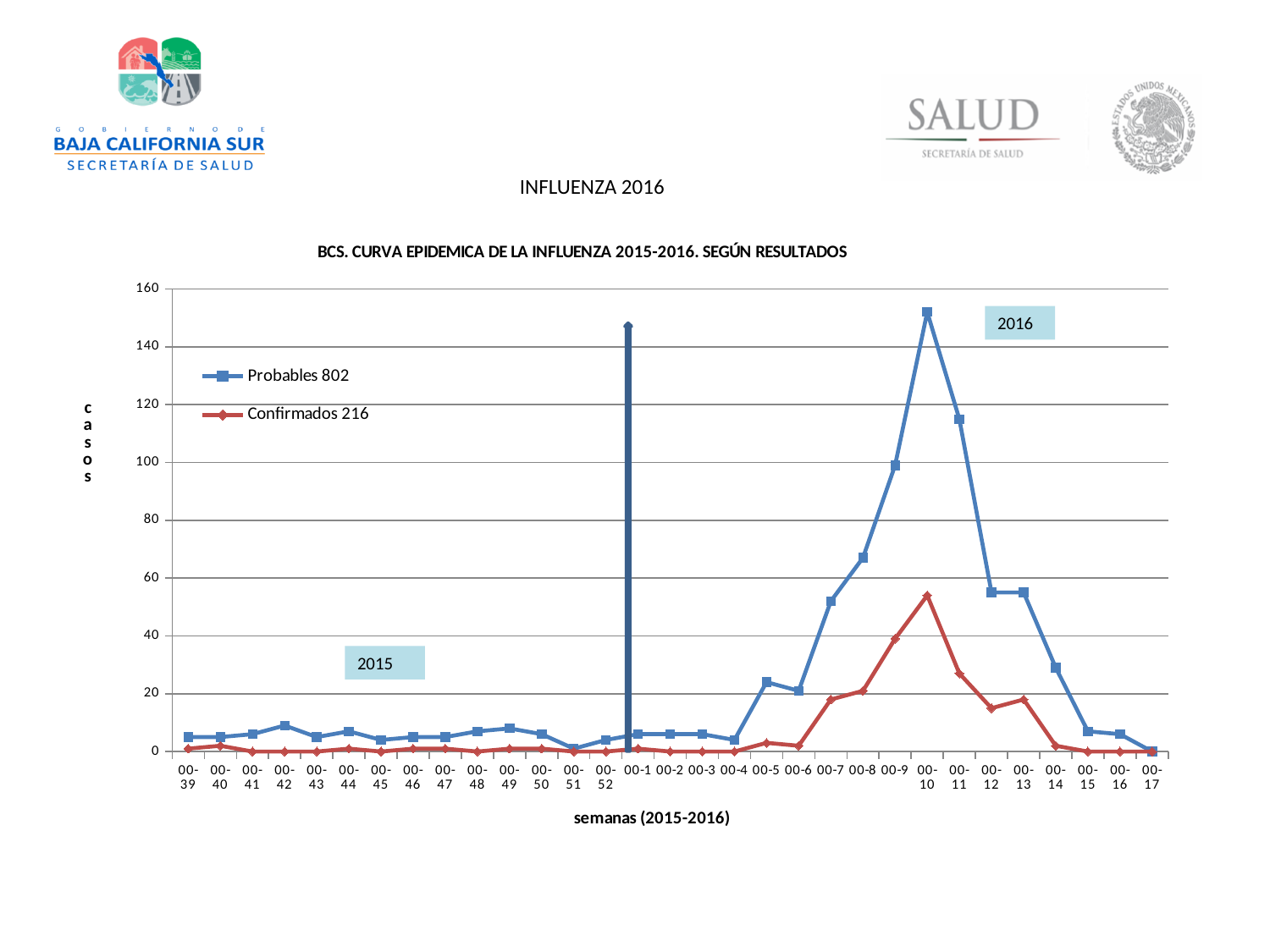
In which week does the Probables series reach its highest value? 00-10 What are the two series named in the legend? Probables 802 and Confirmados 216 Do the Probables values rise or fall from week 00-10 to week 00-17? fall Which series has the larger value in week 00-10, Probables or Confirmados? Probables What is the title of the chart? BCS. CURVA EPIDEMICA DE LA INFLUENZA 2015-2016. SEGÚN RESULTADOS What kind of chart is shown on the slide? line chart How many series does the legend list? 2 Is the value for Confirmados in week 00-10 greater or less than 40? greater Is the value for Probables in week 00-10 greater or less than 140? greater Is the value for Confirmados in week 00-11 greater or less than 20? greater In which week does the Confirmados series reach its highest value? 00-10